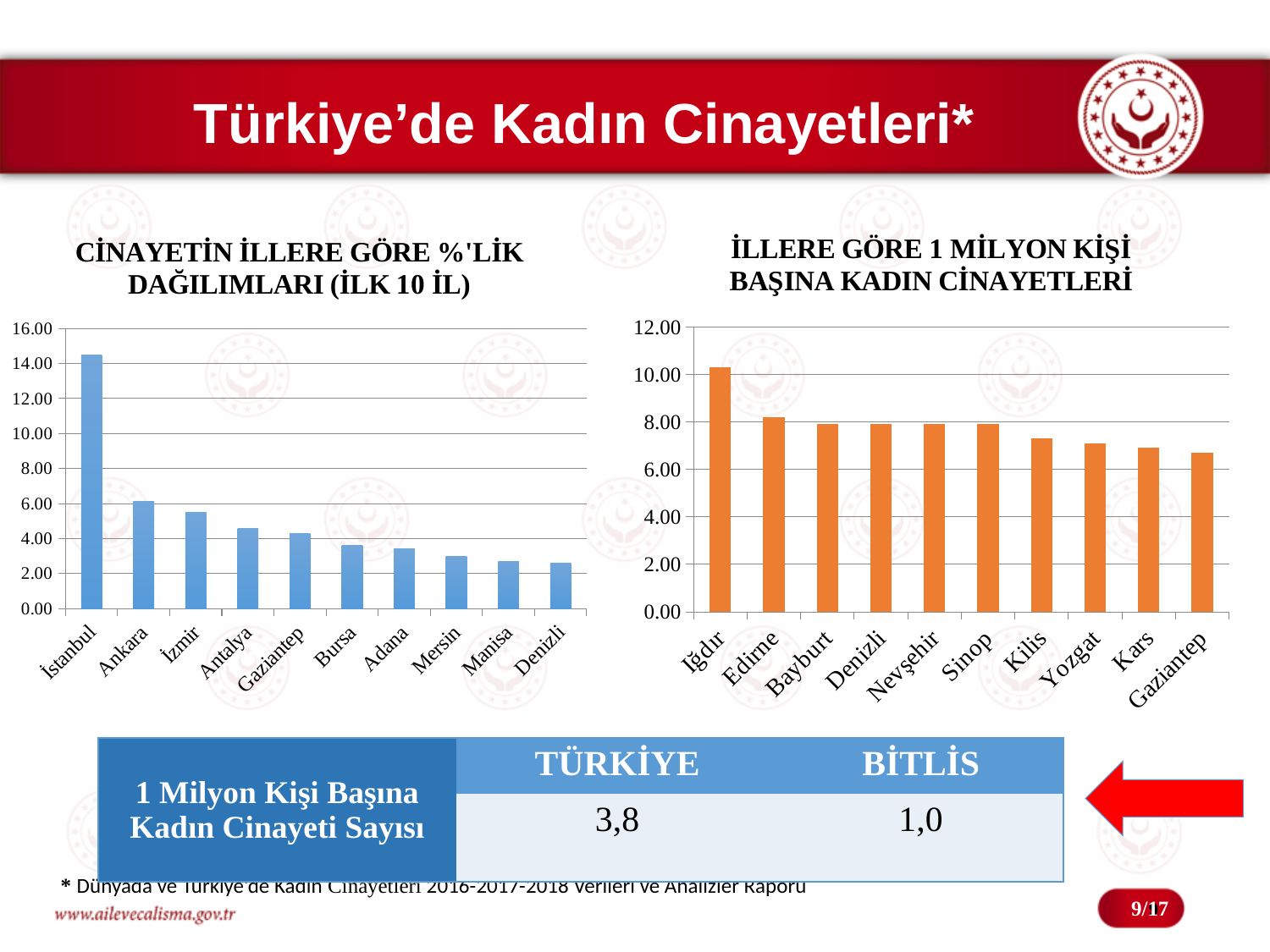
In the left chart, which is larger, the value for İzmir or the value for Bursa? İzmir In the right chart, which is larger, the value for Edirne or the value for Kars? Edirne In the chart titled 'İLLERE GÖRE 1 MİLYON KİŞİ BAŞINA KADIN CİNAYETLERİ', which city has the highest value? Iğdır In the right chart, is the value for Gaziantep greater or less than 8.00? less In the chart titled 'CİNAYETİN İLLERE GÖRE %'LİK DAĞILIMLARI (İLK 10 İL)', which city has the lowest value? Denizli In the left chart, is the value for Ankara greater or less than 8.00? less In the chart titled 'CİNAYETİN İLLERE GÖRE %'LİK DAĞILIMLARI (İLK 10 İL)', which city has the highest value? İstanbul In the left chart, is the value for İstanbul greater or less than 14.00? greater What type of chart is the chart titled 'İLLERE GÖRE 1 MİLYON KİŞİ BAŞINA KADIN CİNAYETLERİ'? bar chart In the left chart, do the values rise or fall from İstanbul to Denizli along the x axis? fall In the left chart, how many cities are shown on the x axis? 10